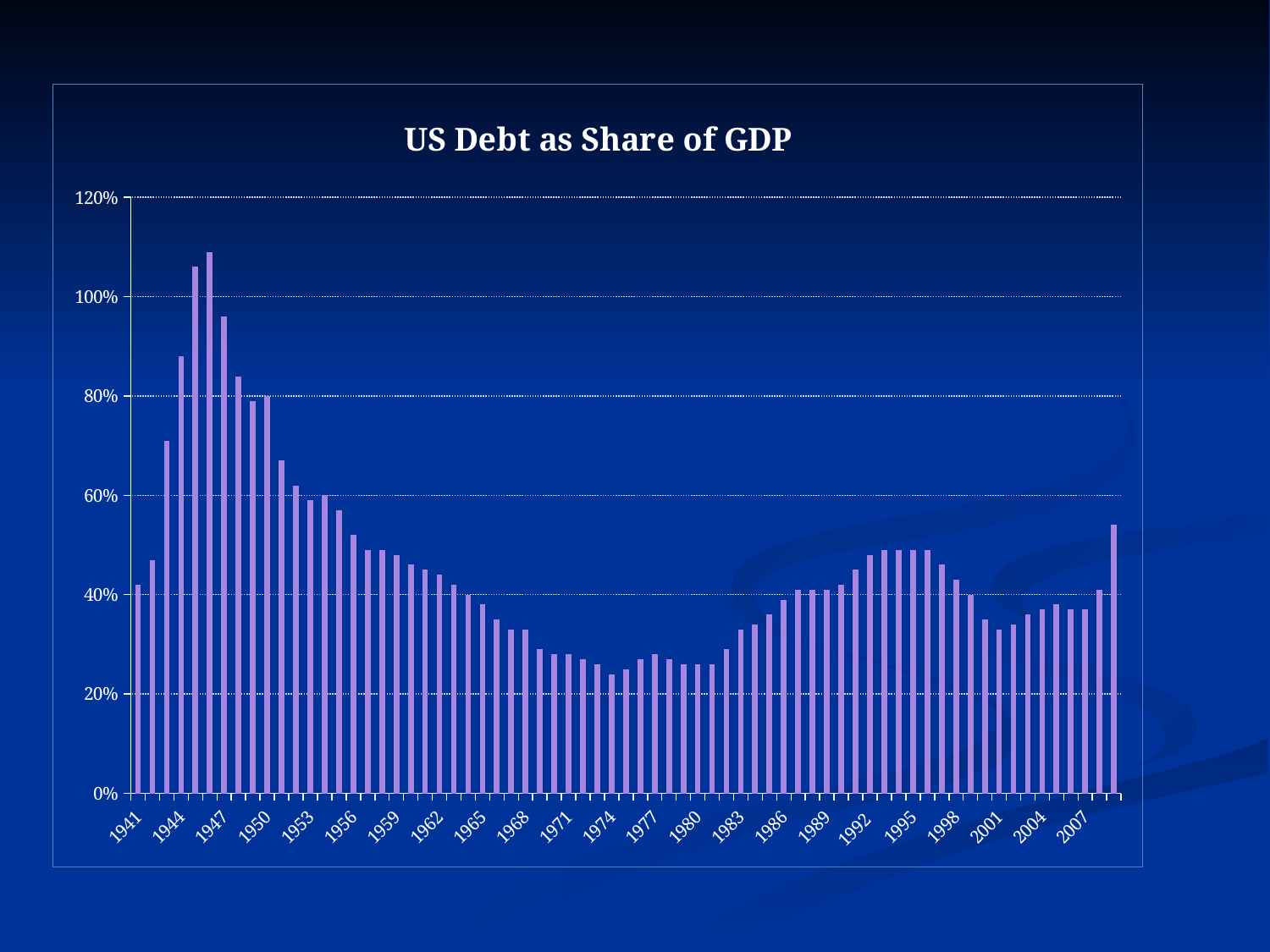
Which year has the larger value, 1944 or 1980? 1944 Is the value for 1968 greater or less than 40%? less What kind of chart is shown on the slide? bar chart Is the value for 1944 greater or less than 80%? greater Is the value for 1992 greater or less than 40%? greater What is the title of the chart? US Debt as Share of GDP What is the highest value shown on the vertical axis? 120% Do the values generally rise or fall from 1947 to 1974? fall